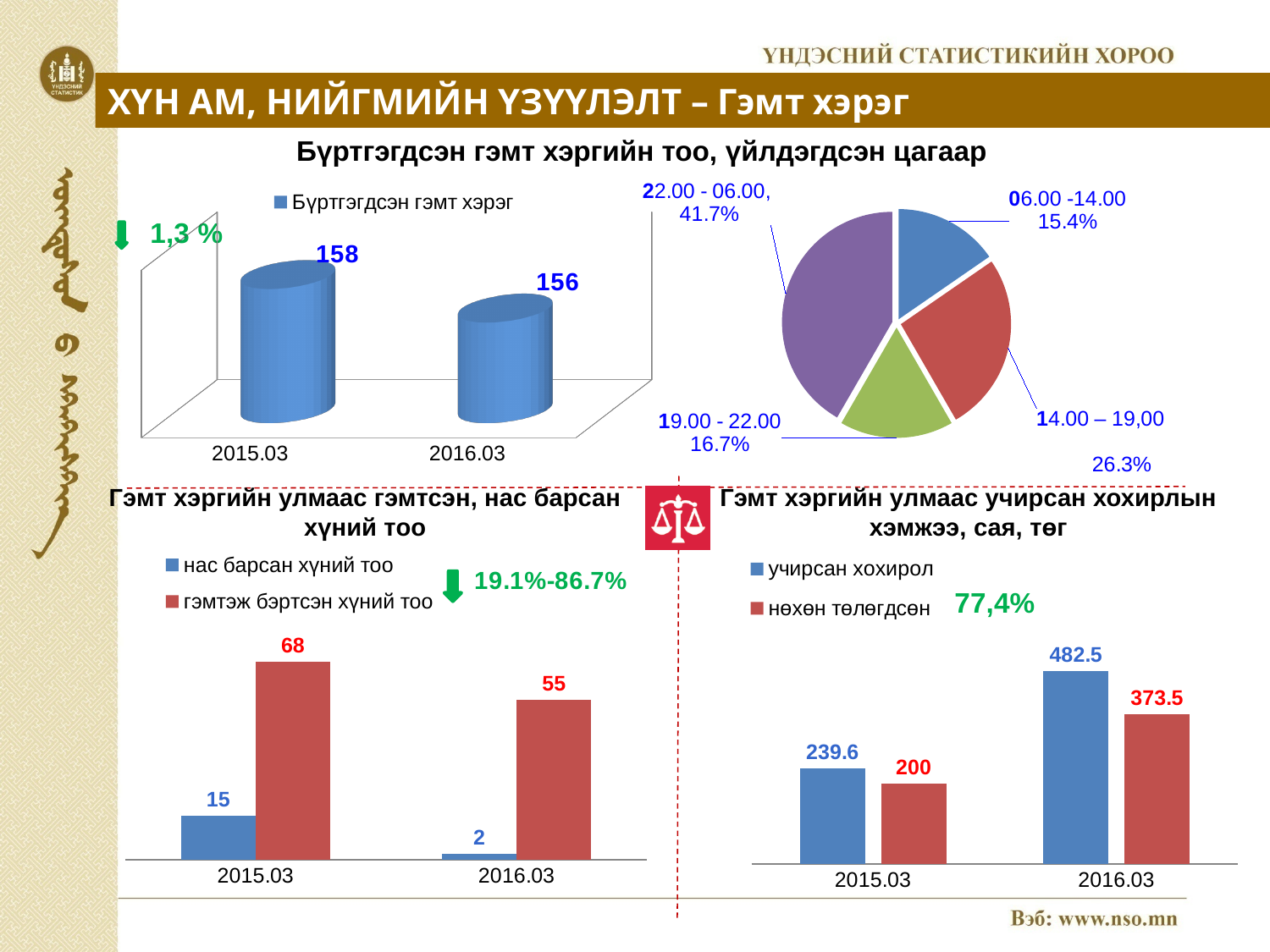
In the top-left bar chart of registered crimes, what is the difference between the 2015.03 and 2016.03 values? 2 In the bottom-left chart (Гэмт хэргийн улмаас гэмтсэн, нас барсан хүний тоо), what is the value for гэмтэж бэртсэн хүний тоо in 2015.03? 68 In the top-right pie chart, what share is shown for the 22.00 - 06.00 slice? 41.7% In the bottom-right chart (Гэмт хэргийн улмаас учирсан хохирлын хэмжээ), what is the difference between учирсан хохирол and нөхөн төлөгдсөн in 2015.03? 39.6 In the top-right pie chart, how many slices are there? 4 In the bottom-left chart (Гэмт хэргийн улмаас гэмтсэн, нас барсан хүний тоо), what is the value for нас барсан хүний тоо in 2016.03? 2 In the top-left bar chart of registered crimes, what is the value for 2016.03? 156 In the bottom-right chart (Гэмт хэргийн улмаас учирсан хохирлын хэмжээ), what is the value for учирсан хохирол in 2016.03? 482.5 In the top-right pie chart, which time period has the smallest share? 06.00 -14.00 In the bottom-left chart (Гэмт хэргийн улмаас гэмтсэн, нас барсан хүний тоо), how many series does the legend list? 2 In the top-left bar chart of registered crimes, what is the value for 2015.03? 158 What kind of chart is the top-right chart showing crimes by time of day? pie chart